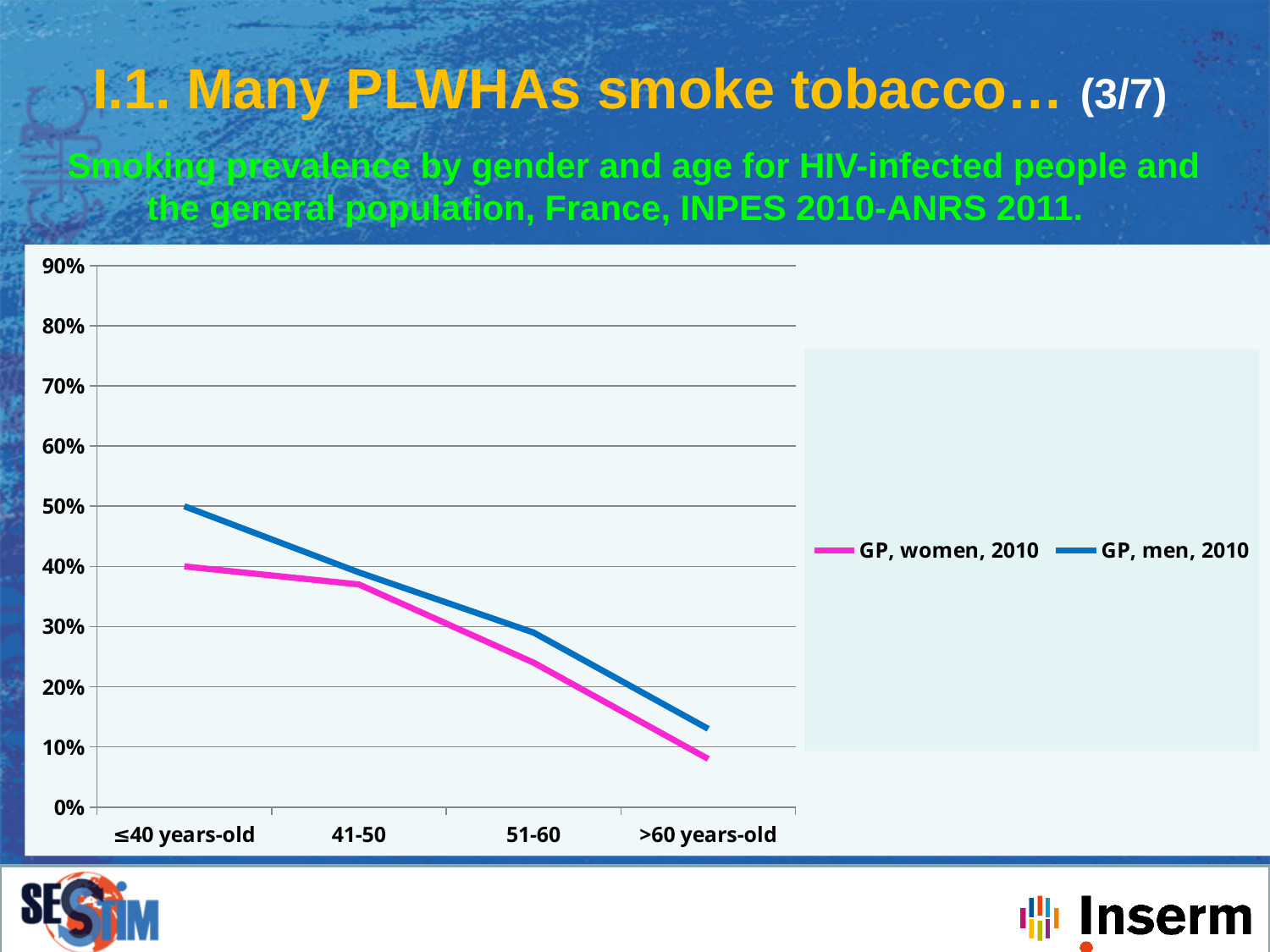
How many age categories are shown on the x axis? 4 Do the values for GP, men, 2010 rise or fall as age increases along the x axis? fall Is the value for GP, women, 2010 in the >60 years-old group greater or less than 10%? less What kind of chart is shown on the slide? line chart What is the smoking prevalence for GP, women, 2010 in the ≤40 years-old group? 40% Which age group has the lowest value for GP, women, 2010? >60 years-old In the 51-60 group, which series has the larger value, GP, women, 2010 or GP, men, 2010? GP, men, 2010 Is the value for GP, women, 2010 in the 51-60 group greater or less than 30%? less Which age group has the highest value for GP, men, 2010? ≤40 years-old Is the value for GP, men, 2010 in the >60 years-old group greater or less than 10%? greater How many series does the legend list? 2 What is the smoking prevalence for GP, men, 2010 in the ≤40 years-old group? 50%